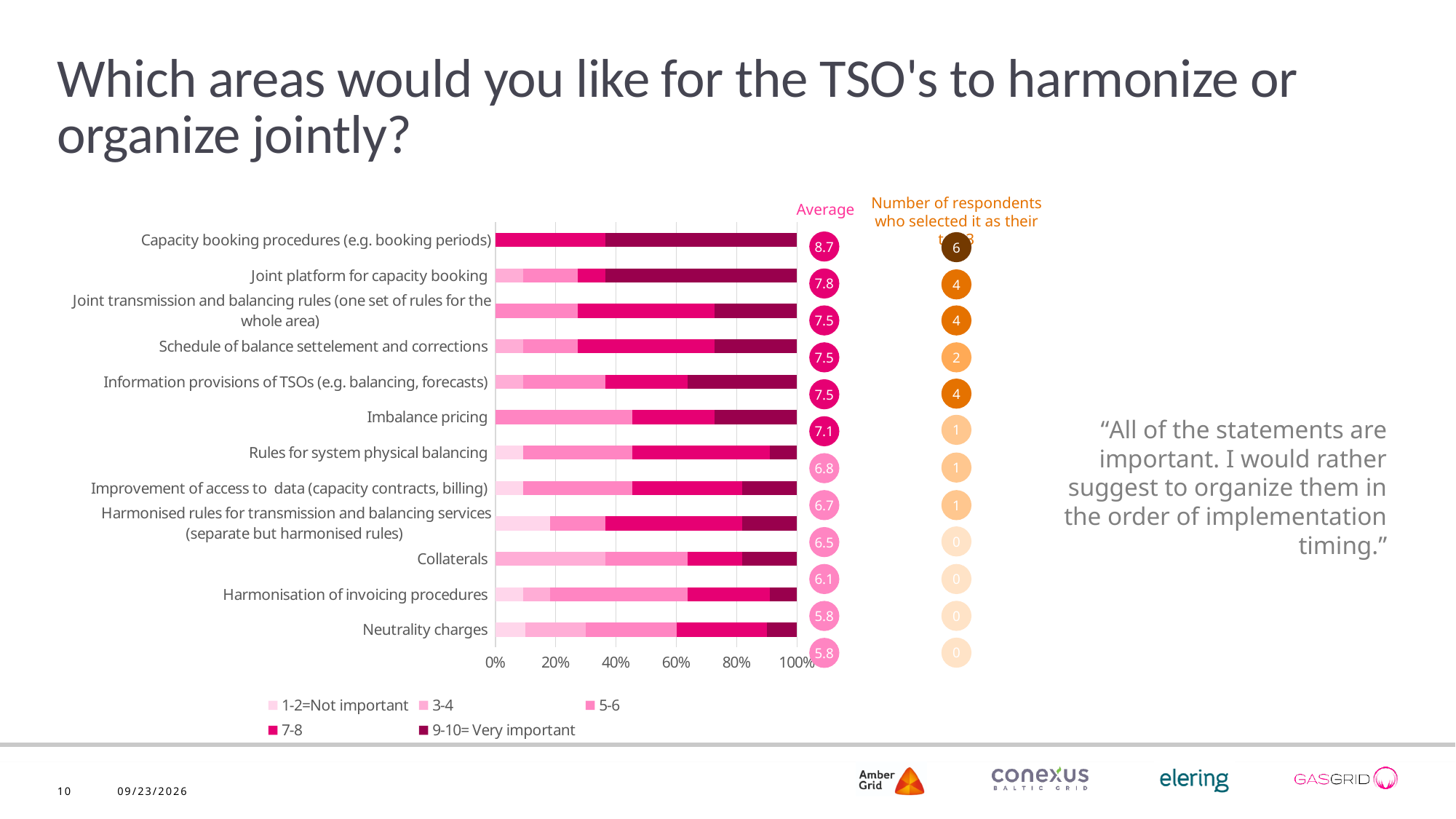
What kind of chart is shown on the slide? Stacked bar chart How many areas (categories) are listed in the chart? 12 Which area has the highest number of respondents selecting it as their top 3? Capacity booking procedures (e.g. booking periods) What is the average score for 'Imbalance pricing'? 7.1 Which has a higher average score, 'Imbalance pricing' or 'Collaterals'? Imbalance pricing Which area has the highest average score? Capacity booking procedures (e.g. booking periods) What is the difference between the average scores of 'Capacity booking procedures' and 'Joint platform for capacity booking'? 0.9 Is the '9-10= Very important' share for 'Neutrality charges' greater or less than 20%? less What is the average score for 'Capacity booking procedures (e.g. booking periods)'? 8.7 How many series does the chart legend list? 5 How many respondents selected 'Joint platform for capacity booking' as their top 3? 4 Which legend entry corresponds to the darkest colour in the chart? 9-10= Very important